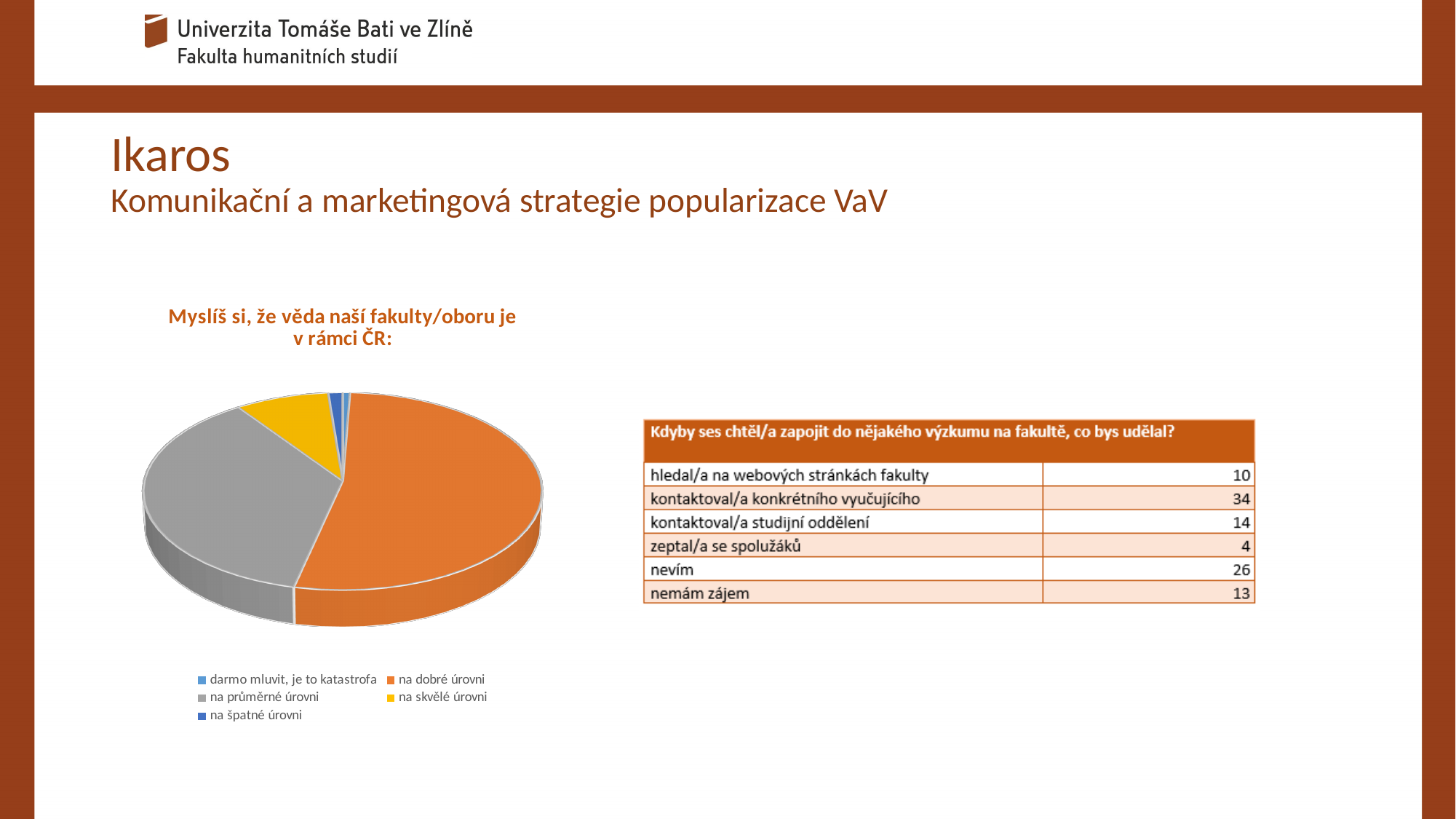
Which category is the second largest slice in the pie chart? na průměrné úrovni What kind of chart is shown on the slide? pie chart Which category has the largest slice in the pie chart? na dobré úrovni Which slice is larger in the pie chart: 'na skvělé úrovni' or 'na špatné úrovni'? na skvělé úrovni What is the title of the pie chart? Myslíš si, že věda naší fakulty/oboru je v rámci ČR: Which colour represents 'na skvělé úrovni' in the pie chart? yellow Which slice is larger in the pie chart: 'na dobré úrovni' or 'na průměrné úrovni'? na dobré úrovni How many categories does the pie chart's legend list? 5